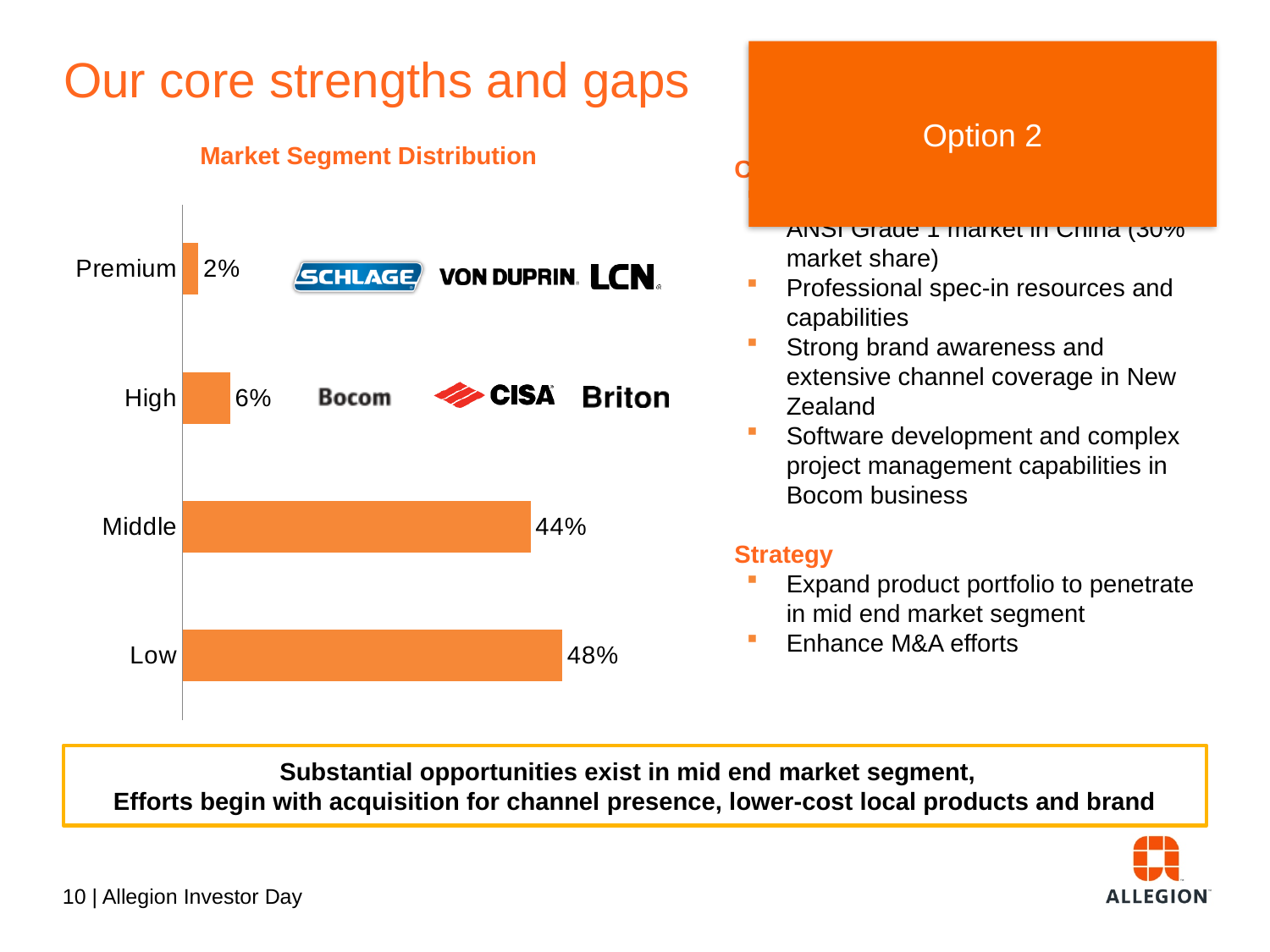
What is the value for the High segment in the Market Segment Distribution chart? 6% Which segment has the lowest value in the Market Segment Distribution chart? Premium What is the value for the Middle segment in the Market Segment Distribution chart? 44% How many segments are shown in the Market Segment Distribution chart? 4 What is the difference between the Low and Middle values in the Market Segment Distribution chart? 4% What is the value for the Low segment in the Market Segment Distribution chart? 48% What is the title of the chart on the left of the slide? Market Segment Distribution In the Market Segment Distribution chart, which is larger, the value for High or the value for Premium? High What kind of chart is the Market Segment Distribution chart? Bar chart Which segment has the highest value in the Market Segment Distribution chart? Low What is the value for the Premium segment in the Market Segment Distribution chart? 2% What is the difference between the High and Premium values in the Market Segment Distribution chart? 4%